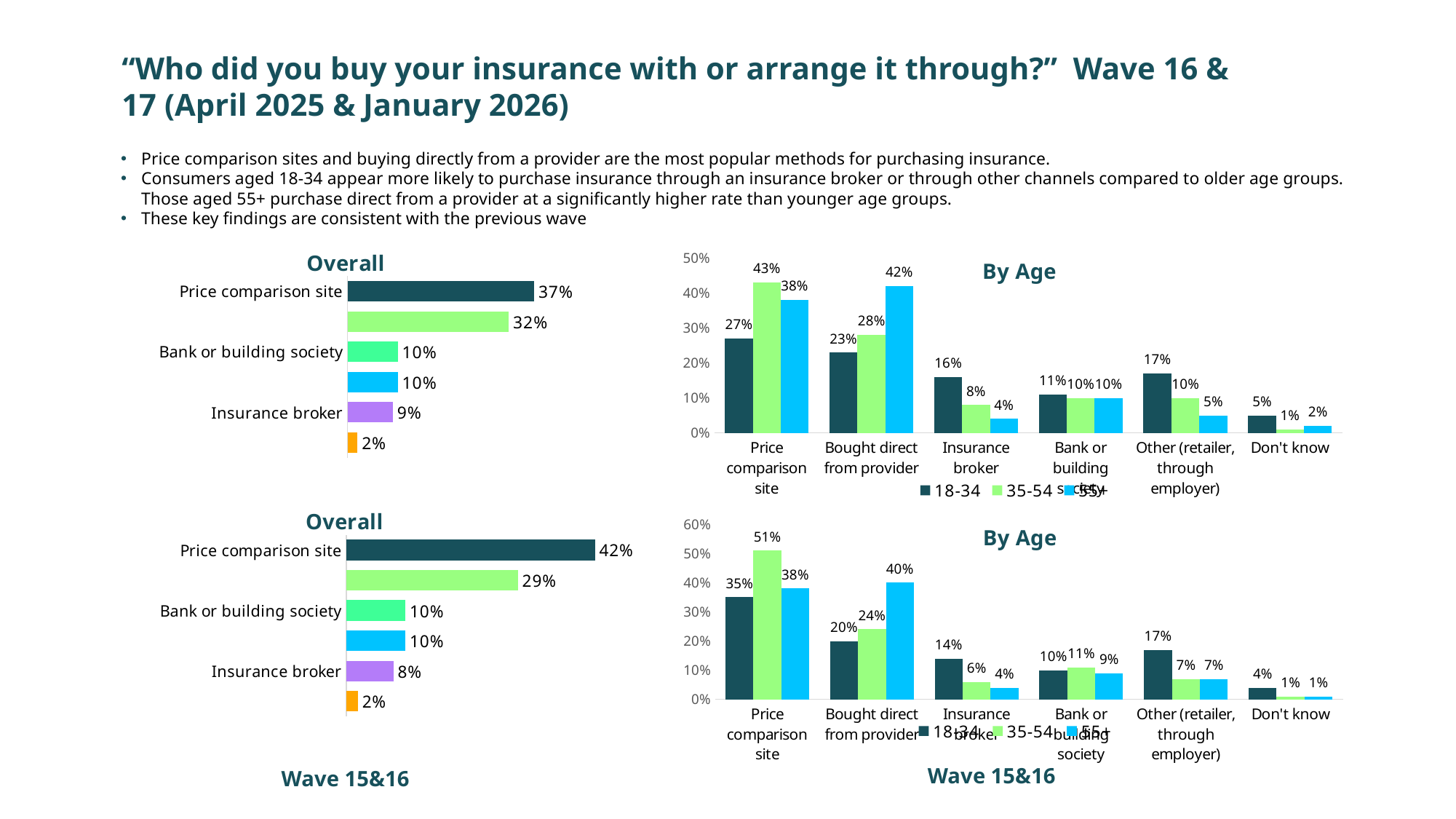
In the bottom-left Overall chart, what is the value for Insurance broker? 8% In the top-right By Age chart, which age group has the lowest value for Insurance broker? 55+ In the top-left Overall chart, what is the value for Price comparison site? 37% In the top-right By Age chart, what is the difference between the 55+ and 18-34 values for Bought direct from provider? 19% What kind of chart is the top-left Overall chart? Bar chart In the bottom-right By Age chart, what is the value for the 55+ group for Bought direct from provider? 40% In the top-right By Age chart, what is the value for the 35-54 group for Price comparison site? 43% In the bottom-right By Age chart, which is larger for Other (retailer, through employer): the 18-34 value or the 35-54 value? 18-34 How many categories are shown on the x axis of the bottom-right By Age chart? 6 What is the difference between the Price comparison site values in the bottom-left Overall chart and the top-left Overall chart? 5% How many series does the legend of the top-right By Age chart list? 3 In the bottom-right By Age chart, which age group has the highest value for Price comparison site? 35-54